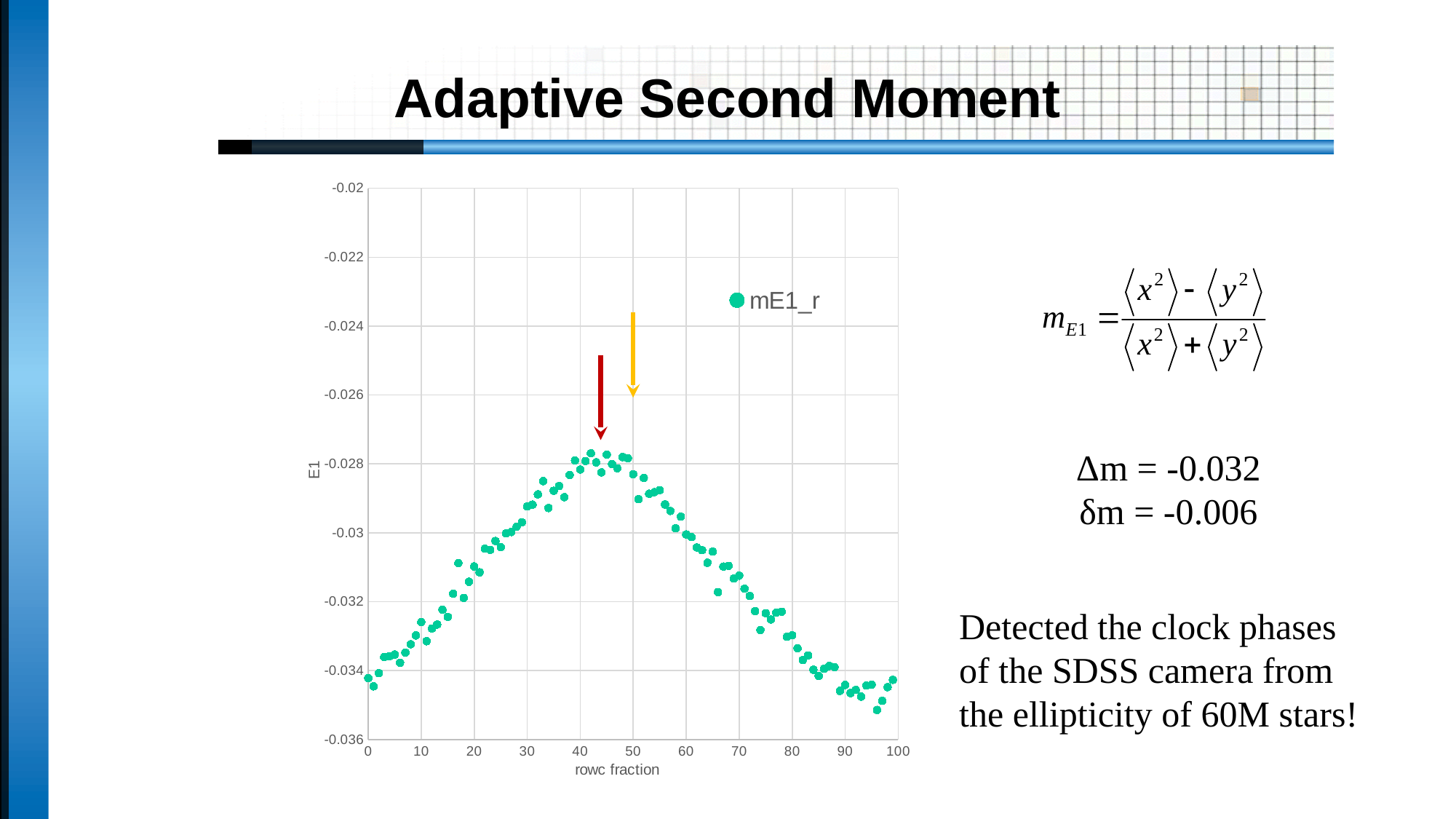
Is the peak value of mE1_r near rowc fraction 43 greater or less than -0.03? greater Which is larger, the mE1_r value at rowc fraction 60 or at rowc fraction 0? rowc fraction 60 What is the name of the series shown in the chart legend? mE1_r Is the value of mE1_r at rowc fraction 20 greater or less than -0.032? greater What kind of chart is shown on the slide? scatter chart What is the title of the x axis of the chart? rowc fraction Is the value of mE1_r at rowc fraction 96 greater or less than -0.034? less Do the mE1_r values rise or fall as rowc fraction increases from 50 to 100? fall How many series does the chart legend list? 1 Do the mE1_r values rise or fall as rowc fraction increases from 0 to 40? rise Which is larger, the mE1_r value at rowc fraction 40 or at rowc fraction 90? rowc fraction 40